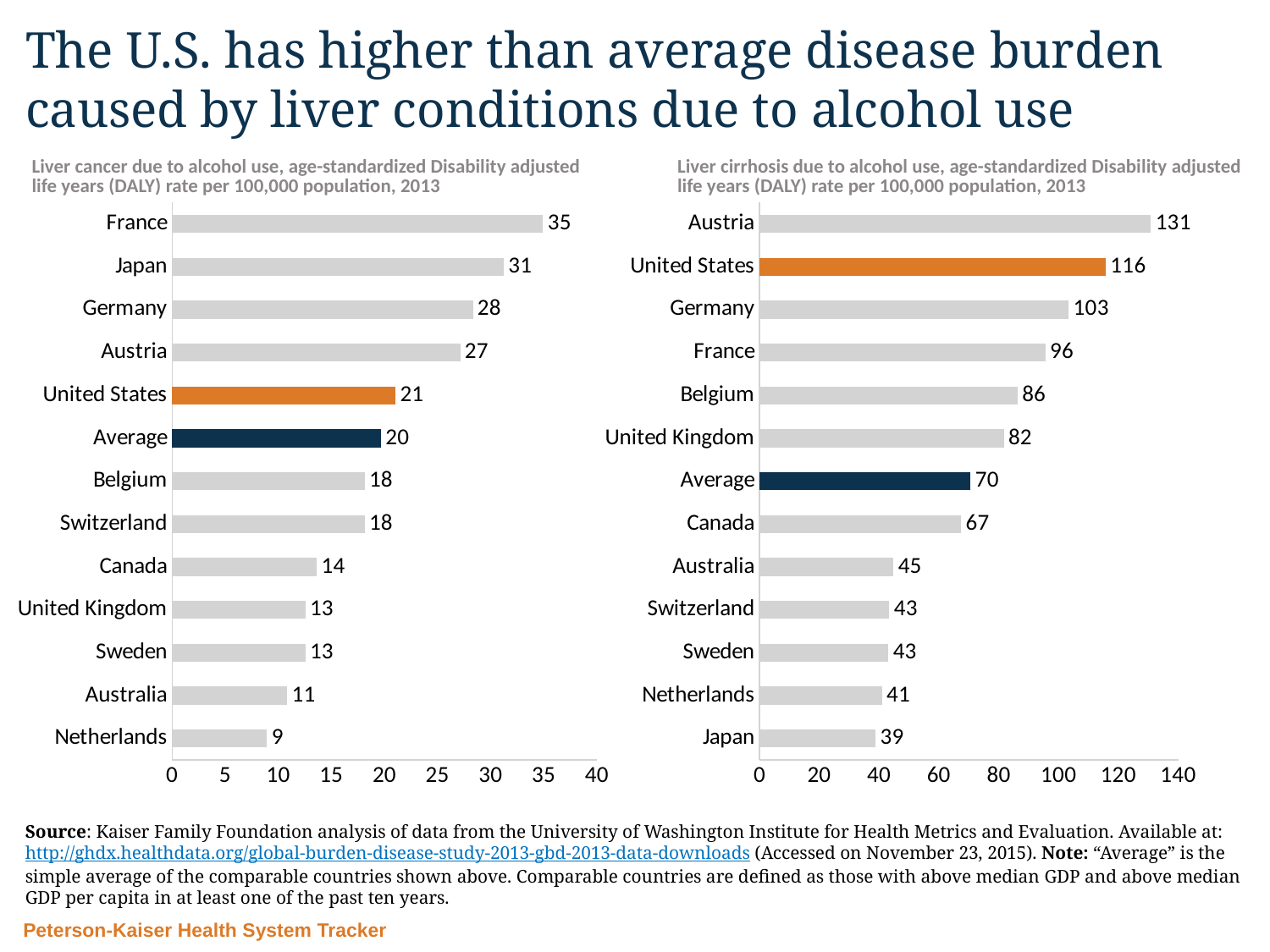
In the liver cancer chart on the left, what is the value for France? 35 In the liver cancer chart on the left, what is the difference between the United States and the Average? 1 In the liver cancer chart on the left, which bar is coloured orange? United States In the liver cirrhosis chart on the right, what is the value for Japan? 39 How many bars are shown in the liver cirrhosis chart on the right? 13 In the liver cirrhosis chart on the right, what is the difference between Austria and the United States? 15 In the liver cirrhosis chart on the right, which country has the highest value? Austria In the liver cirrhosis chart on the right, which is larger, Germany or France? Germany In the liver cancer chart on the left, is the value for Japan greater or less than 30? greater In the liver cancer chart on the left, which country has the lowest value? Netherlands What type of chart is used on the left for liver cancer due to alcohol use? Bar chart In the liver cirrhosis chart on the right, what is the value for the United States? 116